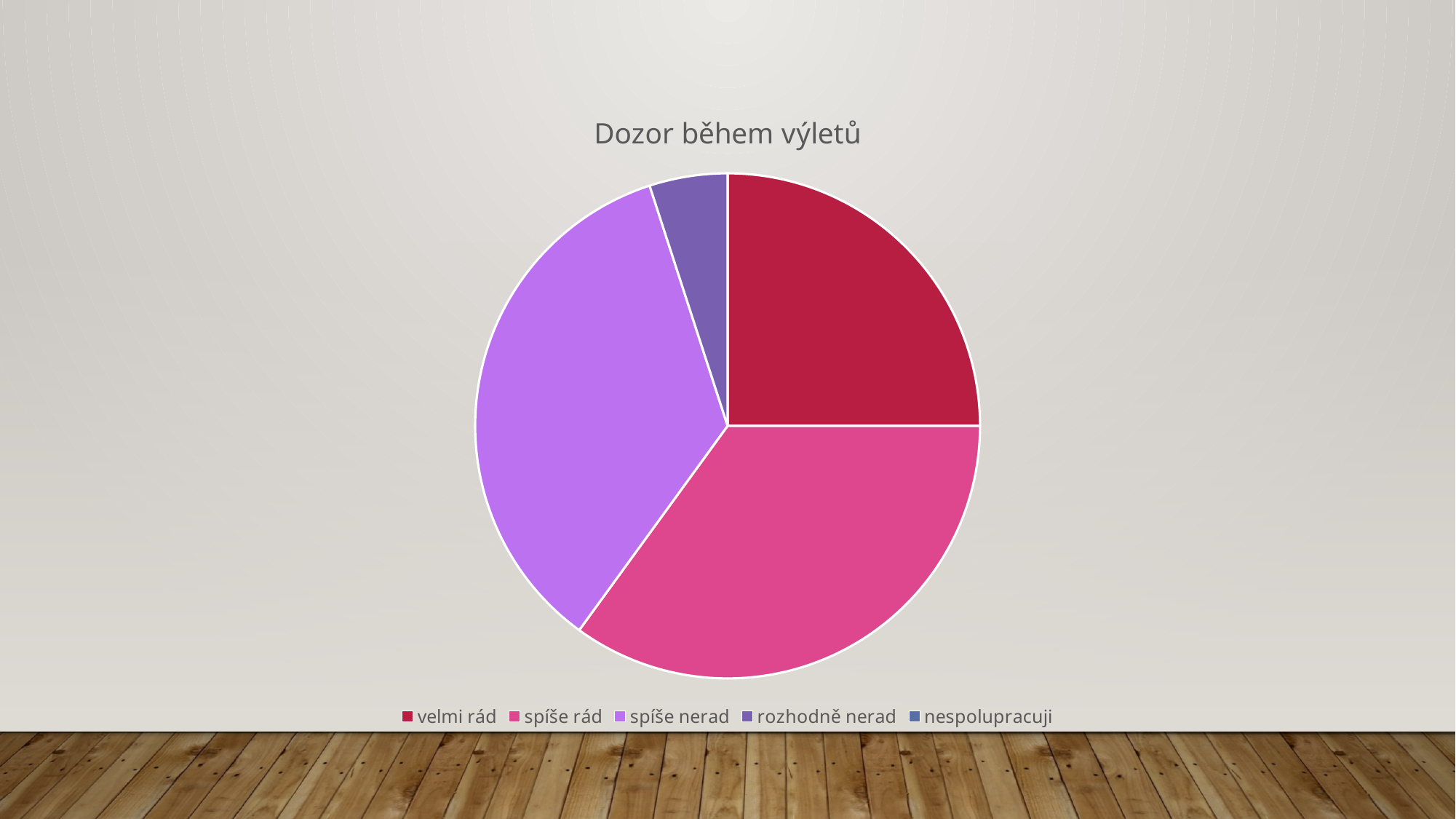
What kind of chart is shown on the slide? pie chart Which slice is smaller, spíše nerad or rozhodně nerad? rozhodně nerad Which slice is larger, velmi rád or rozhodně nerad? velmi rád What colour is the velmi rád slice? dark red How many entries does the chart's legend list? 5 What is the title of the chart? Dozor během výletů Which slice is larger, velmi rád or spíše rád? spíše rád How many slices are visible in the pie? 4 Which of the visible slices is the smallest? rozhodně nerad